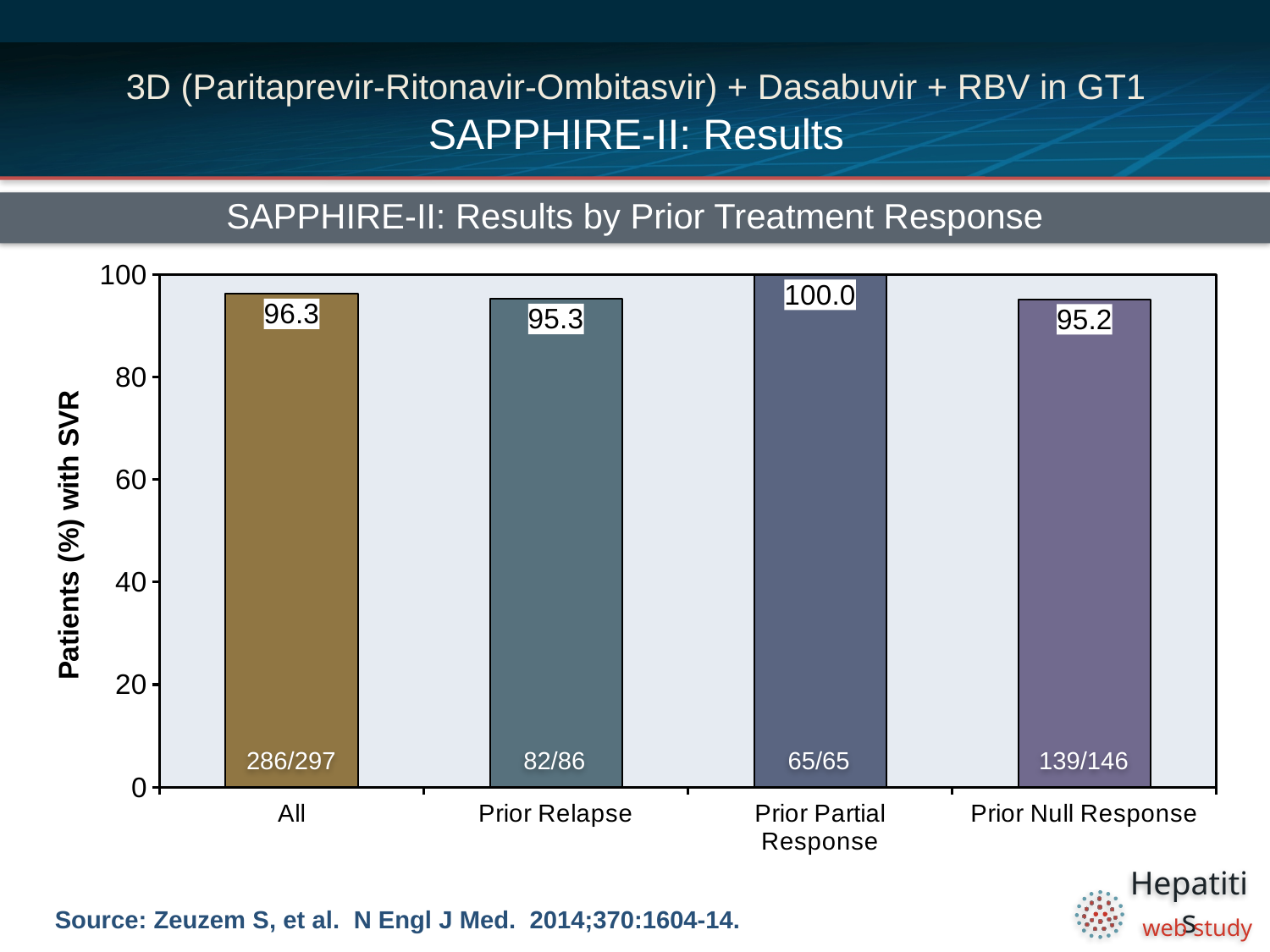
What is the difference in SVR rate between Prior Partial Response and Prior Null Response? 4.8 What is the SVR rate for the Prior Null Response group? 95.2 What is the SVR rate for the All group? 96.3 Which category has the lowest SVR rate? Prior Null Response What kind of chart is shown on the slide? Bar chart What fraction of patients is shown inside the All bar? 286/297 How many categories are shown on the x axis? 4 What is the label of the y axis? Patients (%) with SVR Which category has the highest SVR rate? Prior Partial Response What is the SVR rate for the Prior Relapse group? 95.3 What fraction of patients is shown inside the Prior Partial Response bar? 65/65 Which has a higher SVR rate, All or Prior Relapse? All